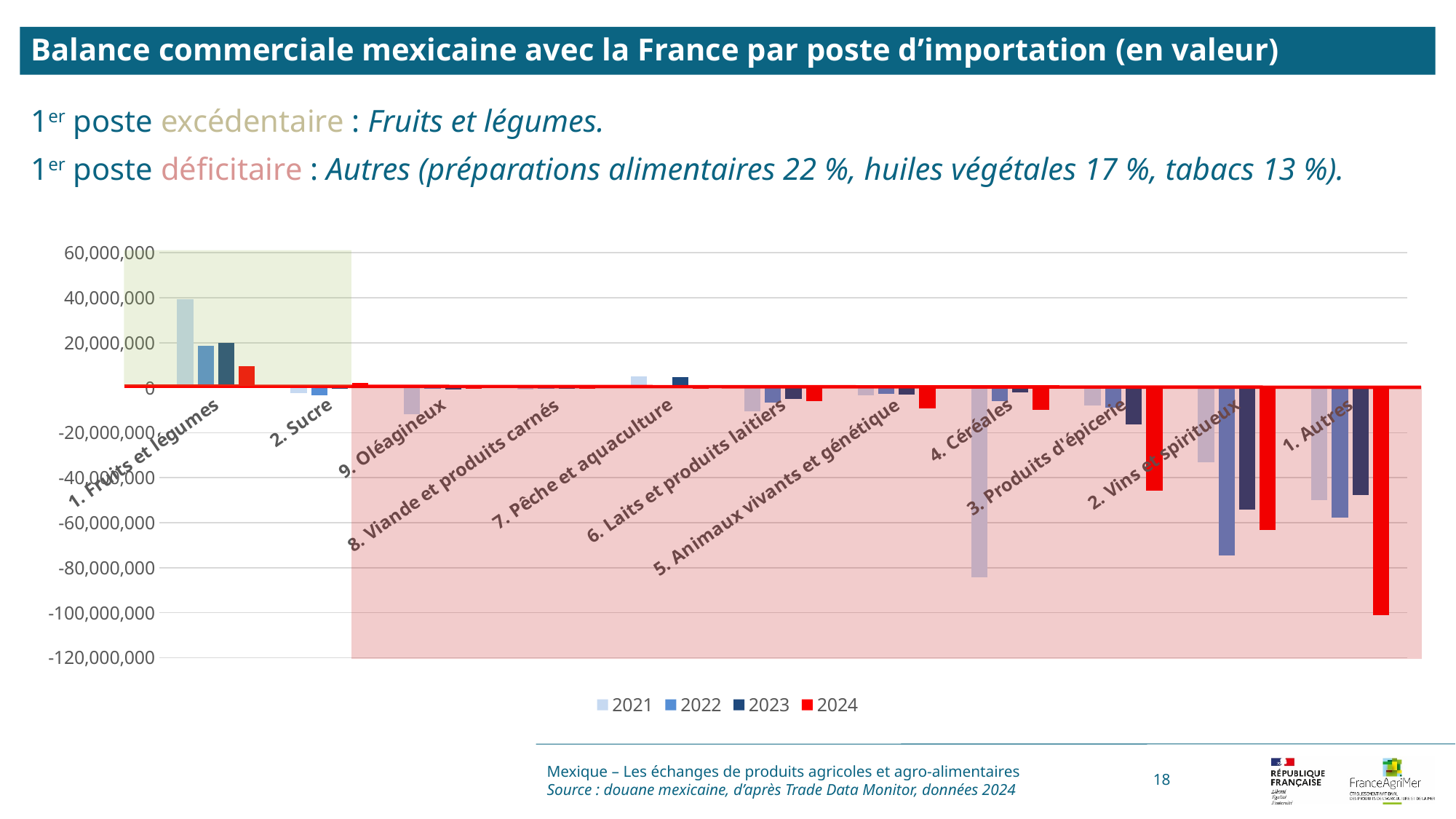
Is the 2021 value for 1. Fruits et légumes greater or less than 20,000,000? greater Which category has the lowest value for 2022? 2. Vins et spiritueux For 1. Fruits et légumes, which year has the larger value, 2021 or 2024? 2021 How many product categories are shown on the x axis? 11 Which colour represents the 2024 series in the legend? Red What kind of chart is shown on the slide? Bar chart Which category has the lowest value for 2024? 1. Autres Is the 2021 value for 4. Céréales greater or less than -60,000,000? less Is the 2024 value for 1. Autres greater or less than -80,000,000? less Which category has the highest value for 2024? 1. Fruits et légumes How many series does the legend list? 4 Which category has the lowest value for 2021? 4. Céréales